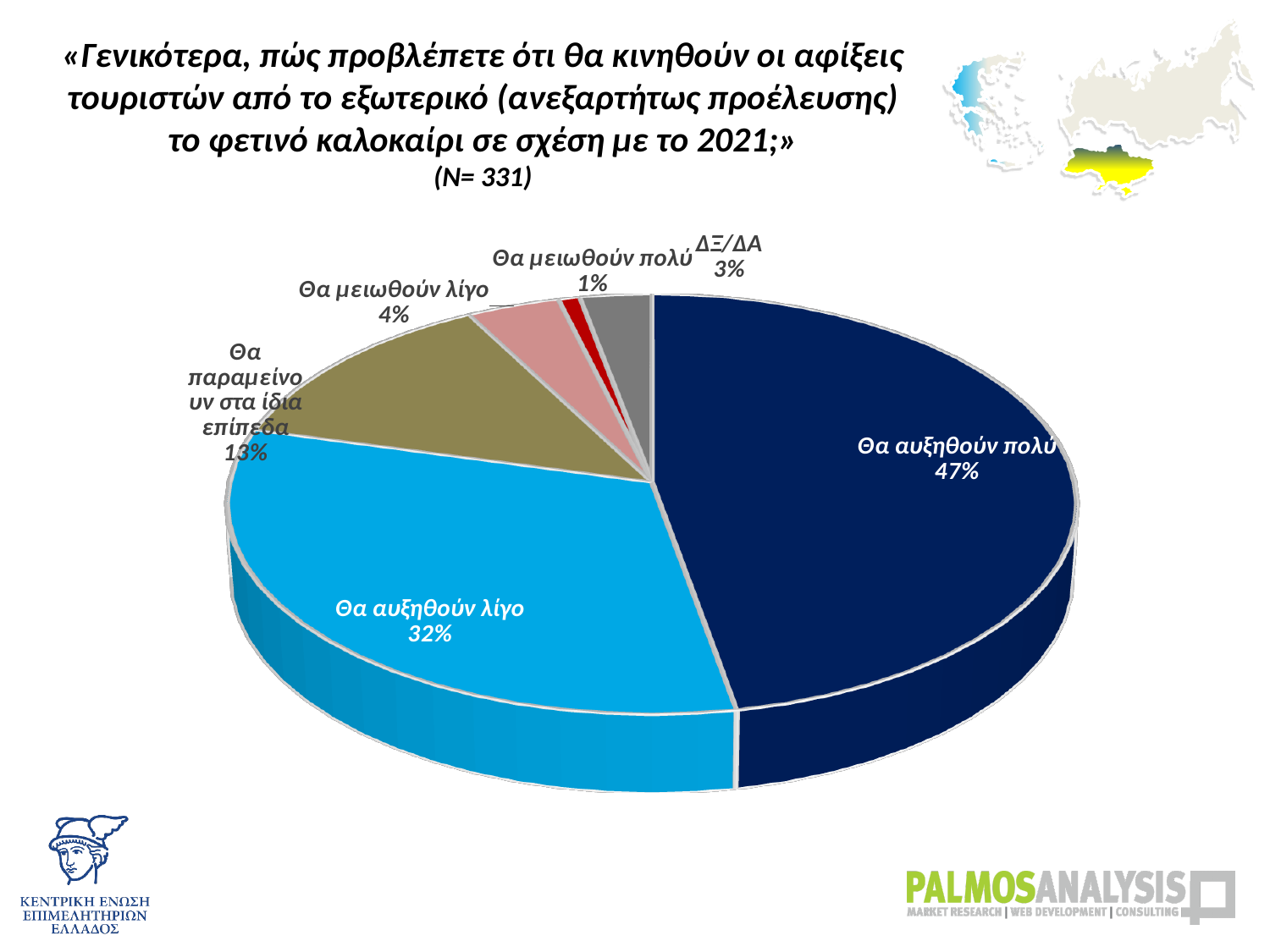
Which is larger: the share for "Θα μειωθούν λίγο" or the share for "ΔΞ/ΔΑ"? Θα μειωθούν λίγο How many slices does the pie chart have? 6 What percentage of respondents answered "Θα αυξηθούν λίγο"? 32% What percentage of respondents answered "ΔΞ/ΔΑ"? 3% What percentage of respondents answered "Θα αυξηθούν πολύ"? 47% What kind of chart is shown on the slide? Pie chart What percentage of respondents answered "Θα μειωθούν λίγο"? 4% Which response has the largest share of the pie? Θα αυξηθούν πολύ What is the difference in percentage points between "Θα αυξηθούν πολύ" and "Θα αυξηθούν λίγο"? 15 percentage points Which response has the smallest share of the pie? Θα μειωθούν πολύ What percentage of respondents answered "Θα παραμείνουν στα ίδια επίπεδα"? 13% What is the sample size (N) stated under the chart title? 331